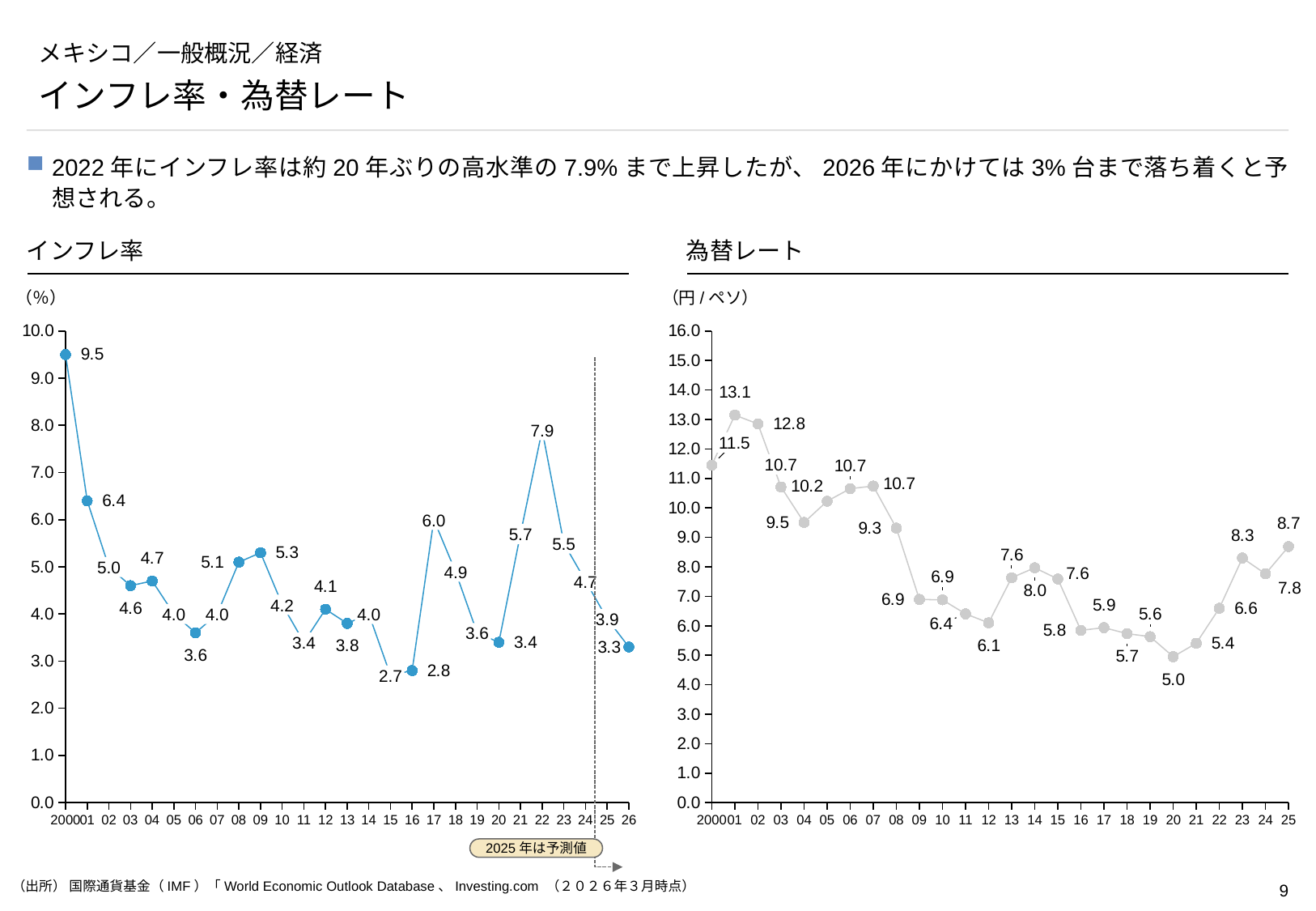
In the インフレ率 chart, what is the value for 2000? 9.5 In the 為替レート chart, what is the difference between the 2025 value and the 2024 value? 0.9 In the 為替レート chart, what is the value for 2001? 13.1 In the インフレ率 chart, what is the forecast value for 2026? 3.3 In the インフレ率 chart, what is the inflation rate for 2022? 7.9 In the 為替レート chart, which year has the lowest value? 2020 In the 為替レート chart, which is larger, the value for 2013 or the value for 2016? 2013 In the インフレ率 chart, which year has the lowest inflation rate? 2015 What unit is shown on the y axis of the 為替レート chart? 円/ペソ In the インフレ率 chart, which is larger, the value for 2017 or the value for 2021? 2017 What type of chart is the 為替レート chart? Line chart In the インフレ率 chart, what is the difference between the 2022 value and the 2023 value? 2.4